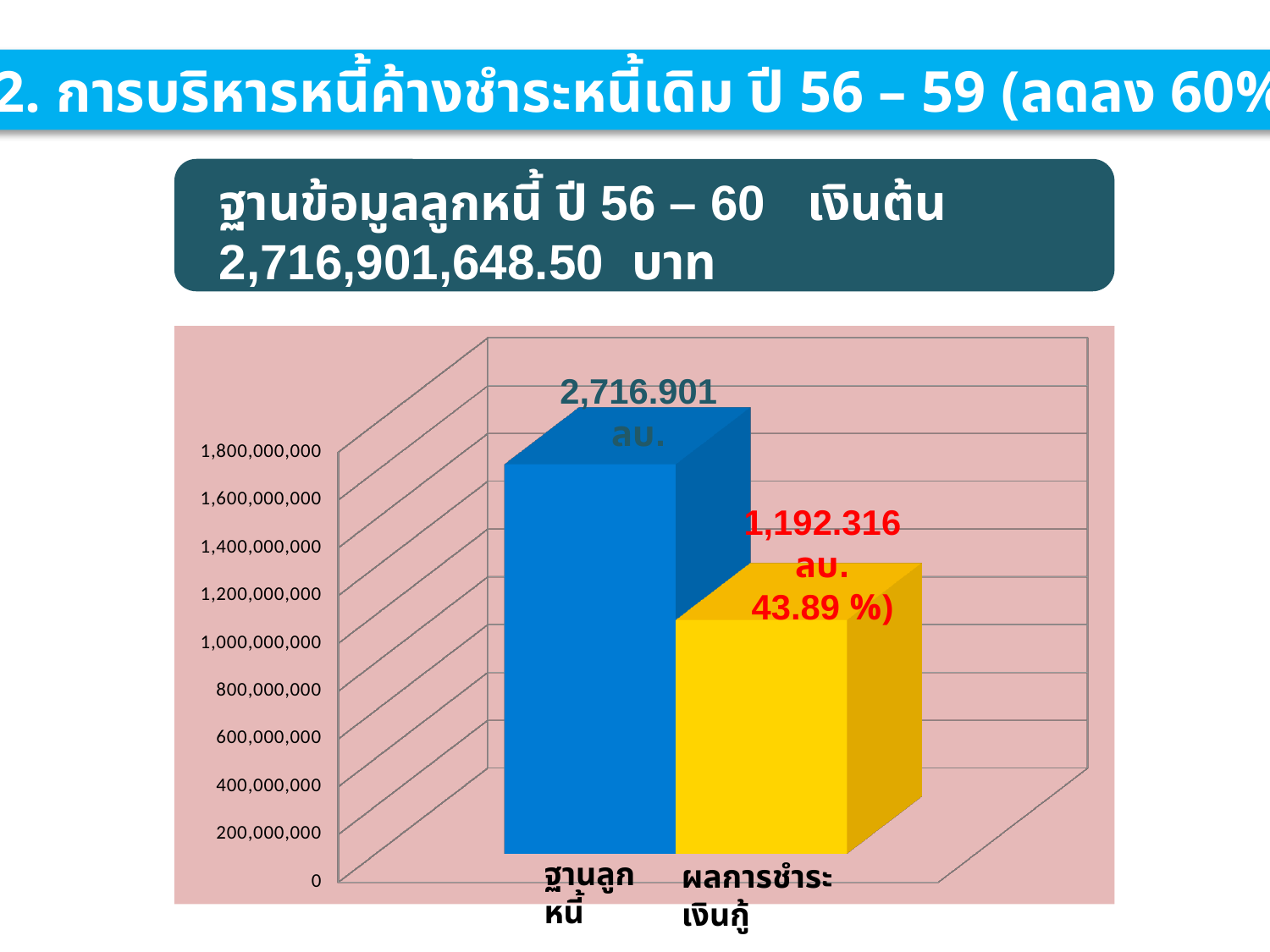
What colour is the bar for ผลการชำระเงินกู้? yellow What value is labelled on the bar for ฐานลูกหนี้? 2,716.901 ลบ. What is the difference between the labelled values for ฐานลูกหนี้ and ผลการชำระเงินกู้ (in ลบ.)? 1,524.585 ลบ. How many bars (categories) does the chart show? 2 What value is labelled on the bar for ผลการชำระเงินกู้? 1,192.316 ลบ. Which category has the highest bar? ฐานลูกหนี้ Which is larger, the value for ฐานลูกหนี้ or the value for ผลการชำระเงินกู้? ฐานลูกหนี้ Is the bar for ฐานลูกหนี้ greater or less than 1,400,000,000 on the axis? greater What type of chart is shown on the slide? bar chart Which category has the lowest bar? ผลการชำระเงินกู้ What percentage is shown with the ผลการชำระเงินกู้ bar? 43.89 %